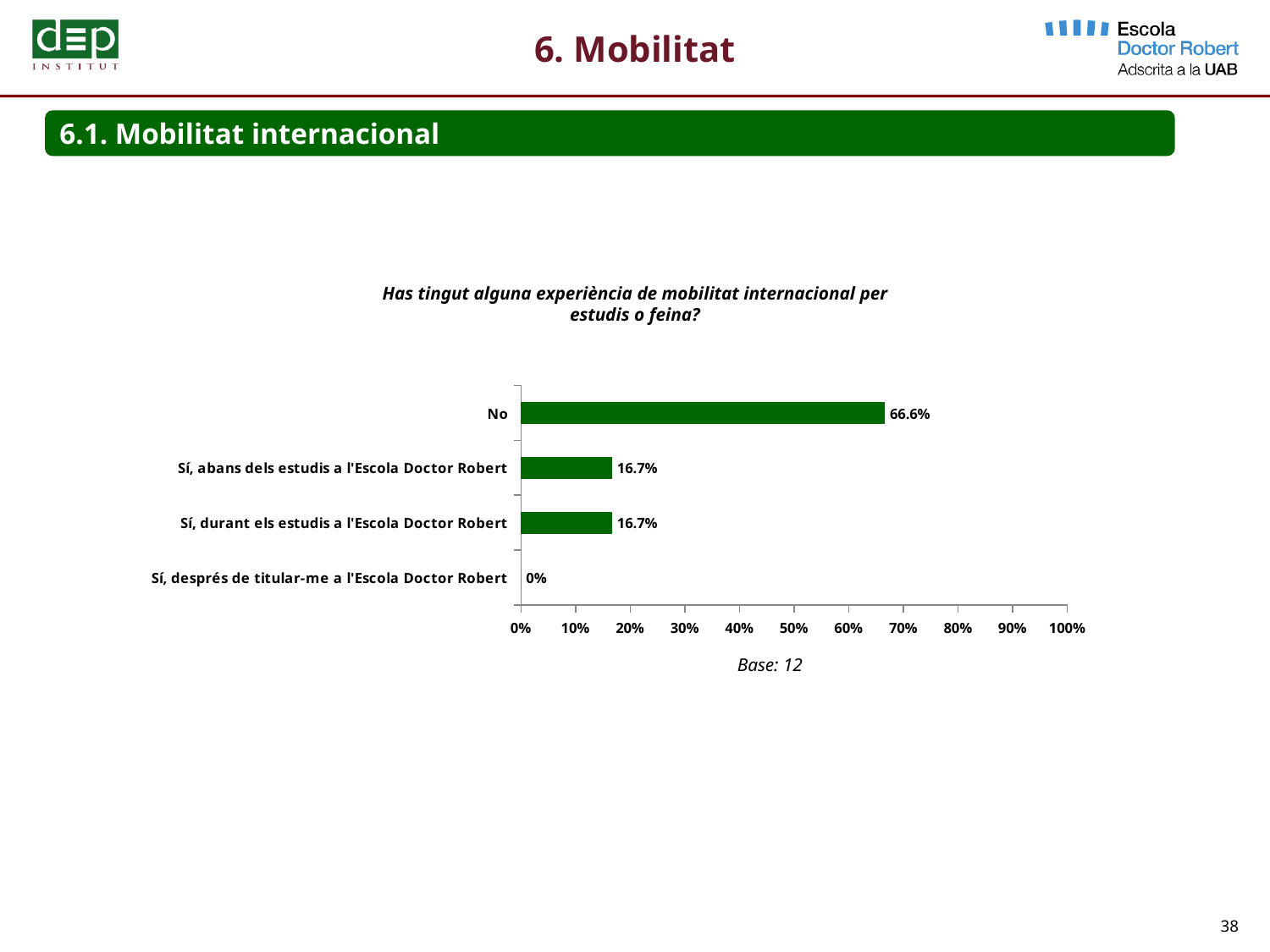
What kind of chart is shown on the slide? Bar chart How many categories are shown in the chart? 4 What is the value for "Sí, abans dels estudis a l'Escola Doctor Robert"? 16.7% What is the value for "No"? 66.6% What is the title of the chart? Has tingut alguna experiència de mobilitat internacional per estudis o feina? What base (number of respondents) is stated below the chart? Base: 12 Which category has the highest value? No Is the value for "No" greater or less than 50%? greater Which category has the lowest value? Sí, després de titular-me a l'Escola Doctor Robert What is the value for "Sí, després de titular-me a l'Escola Doctor Robert"? 0% What is the difference between the value for "No" and the value for "Sí, durant els estudis a l'Escola Doctor Robert"? 49.9% Which is larger: the value for "No" or the value for "Sí, abans dels estudis a l'Escola Doctor Robert"? No